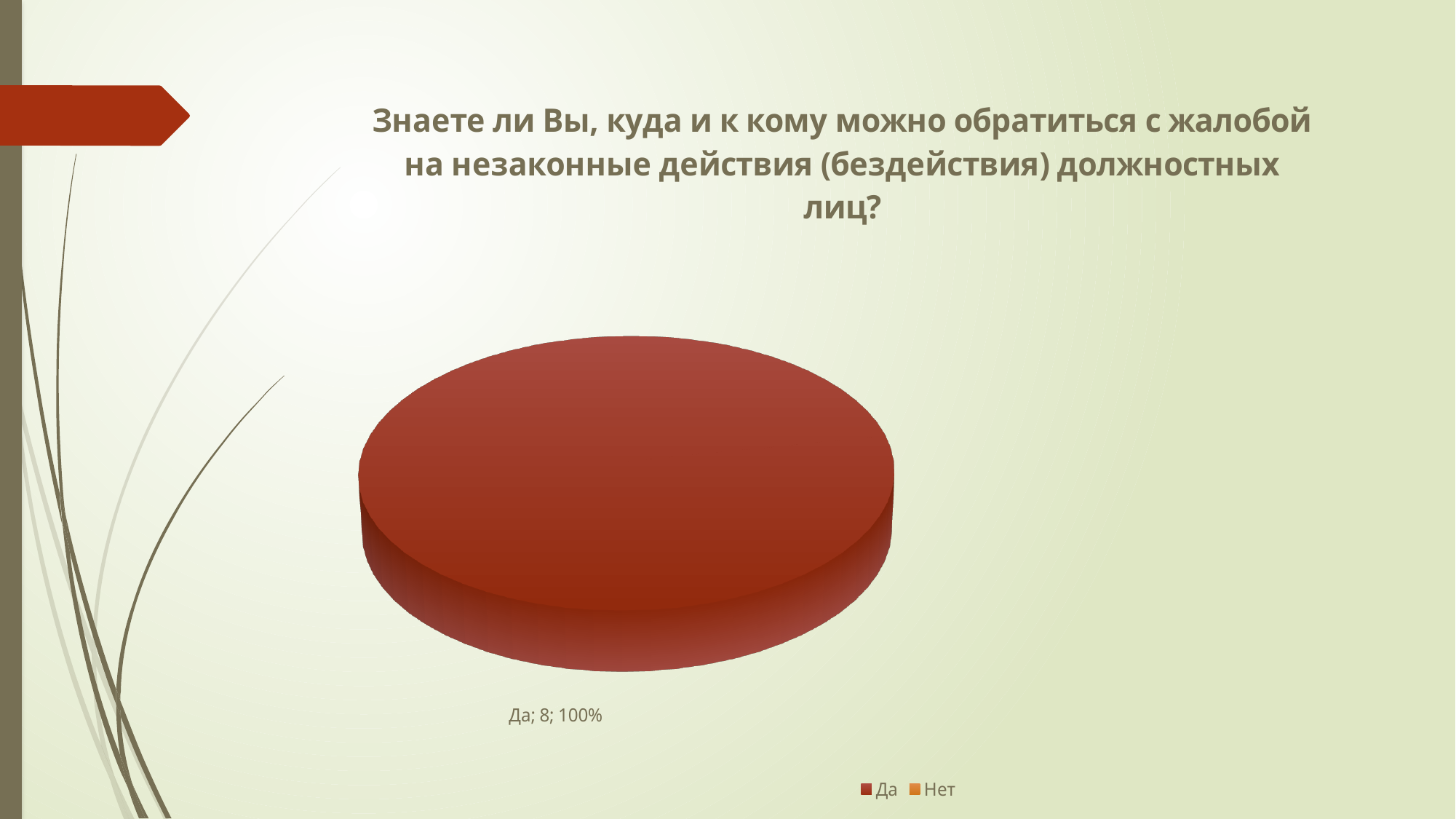
What kind of chart is shown on the slide? pie chart How many slices are visible in the pie? 1 What is the value shown for "Да"? 8 What colour is the "Да" slice? red How many series does the legend list? 2 Is the share for "Да" greater or less than 50%? greater What share of the pie does the "Да" slice take? 100% Which category has the largest slice of the pie? Да Which legend entry has no visible slice in the pie? Нет